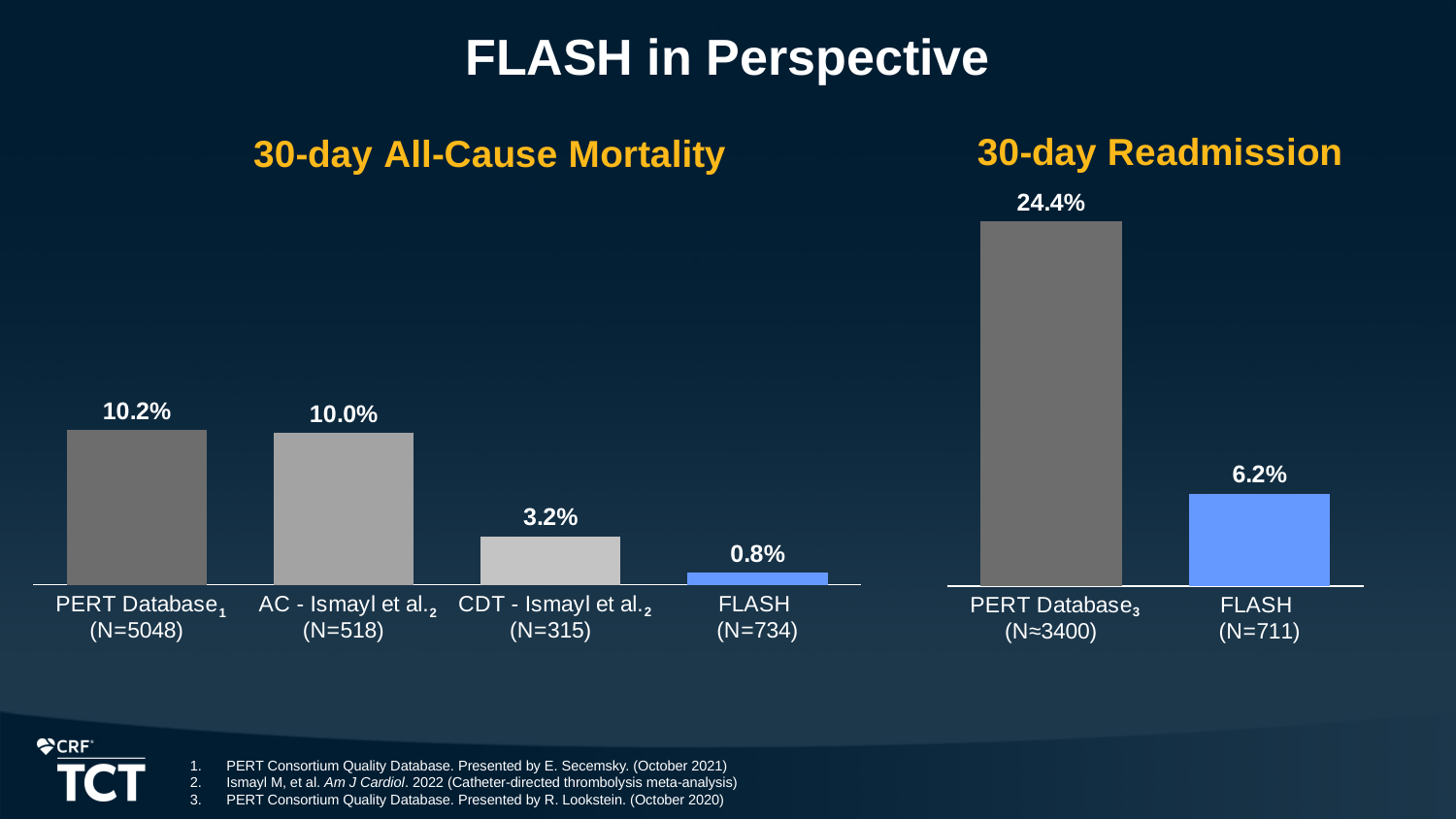
How many categories are shown in the 30-day Readmission chart? 2 In the 30-day Readmission chart, what is the difference between the PERT Database value and the FLASH value? 18.2% In the 30-day All-Cause Mortality chart, what is the value for FLASH? 0.8% How many categories are shown in the 30-day All-Cause Mortality chart? 4 In the 30-day All-Cause Mortality chart, what is the difference between the CDT - Ismayl et al. value and the FLASH value? 2.4% In the 30-day Readmission chart, what is the value for FLASH? 6.2% What kind of chart is the 30-day Readmission chart? Bar chart In the 30-day All-Cause Mortality chart, what is the value for PERT Database? 10.2% In the 30-day All-Cause Mortality chart, which is larger, the value for AC - Ismayl et al. or the value for CDT - Ismayl et al.? AC - Ismayl et al. In the 30-day All-Cause Mortality chart, which category has the highest value? PERT Database In the 30-day All-Cause Mortality chart, which category has the lowest value? FLASH In the 30-day Readmission chart, what is the value for PERT Database? 24.4%